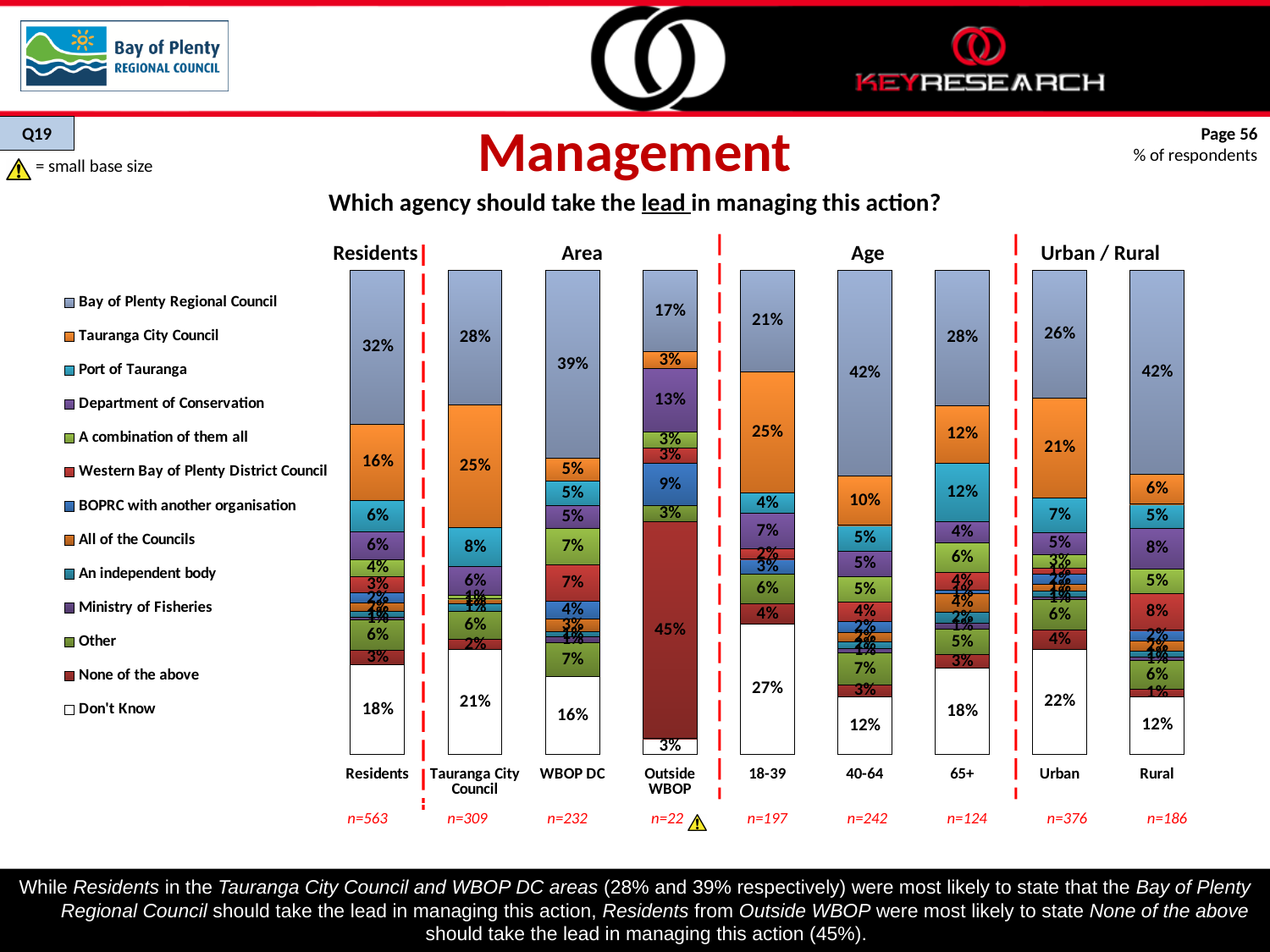
How many series does the legend list? 13 For all Residents, what is the difference between the Bay of Plenty Regional Council share (32%) and the Tauranga City Council share (16%)? 16 percentage points What is the sample size (n) for the Outside WBOP group? n=22 Among the three Area groups, which has the highest share for Bay of Plenty Regional Council? WBOP DC What percentage of Outside WBOP respondents chose None of the above? 45% What percentage of WBOP DC respondents said the Bay of Plenty Regional Council should take the lead? 39% Which respondent group has the lowest Don't Know percentage? Outside WBOP Which has a larger Don't Know share, Urban or Rural respondents? Urban How many bars (respondent groups) are plotted in the chart? 9 What percentage of Tauranga City Council area respondents said Tauranga City Council should take the lead? 25% What kind of chart is shown on the slide? Stacked bar chart What percentage of 18-39 year olds answered Don't Know? 27%